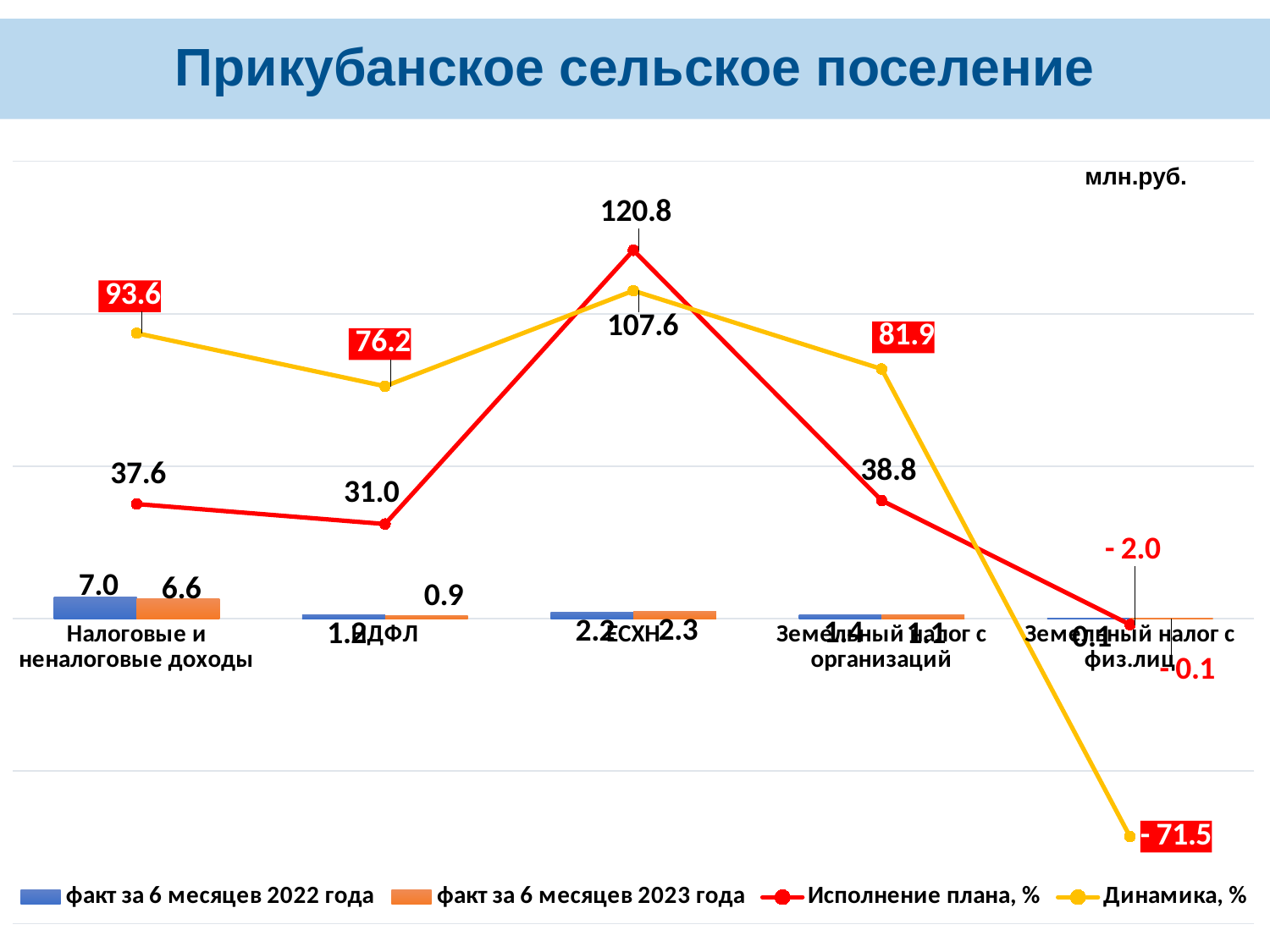
What is the value of 'Динамика, %' for 'Земельный налог с физ.лиц'? -71.5 Which category has the highest value of 'Исполнение плана, %'? ЕСХН What kind of chart is shown on the slide? A combined bar and line chart What is the value of 'Динамика, %' for 'Налоговые и неналоговые доходы'? 93.6 What is the value of 'Динамика, %' for НДФЛ? 76.2 Which category has the lowest value of 'Динамика, %'? Земельный налог с физ.лиц How many series does the legend list? 4 What unit is indicated in the top right corner of the chart? млн.руб. What is the value of 'Исполнение плана, %' for ЕСХН? 120.8 What is the difference between 'факт за 6 месяцев 2022 года' and 'факт за 6 месяцев 2023 года' for 'Налоговые и неналоговые доходы'? 0.4 How many categories are shown on the x axis? 5 Which is larger: 'Исполнение плана, %' for НДФЛ or for 'Земельный налог с организаций'? Земельный налог с организаций